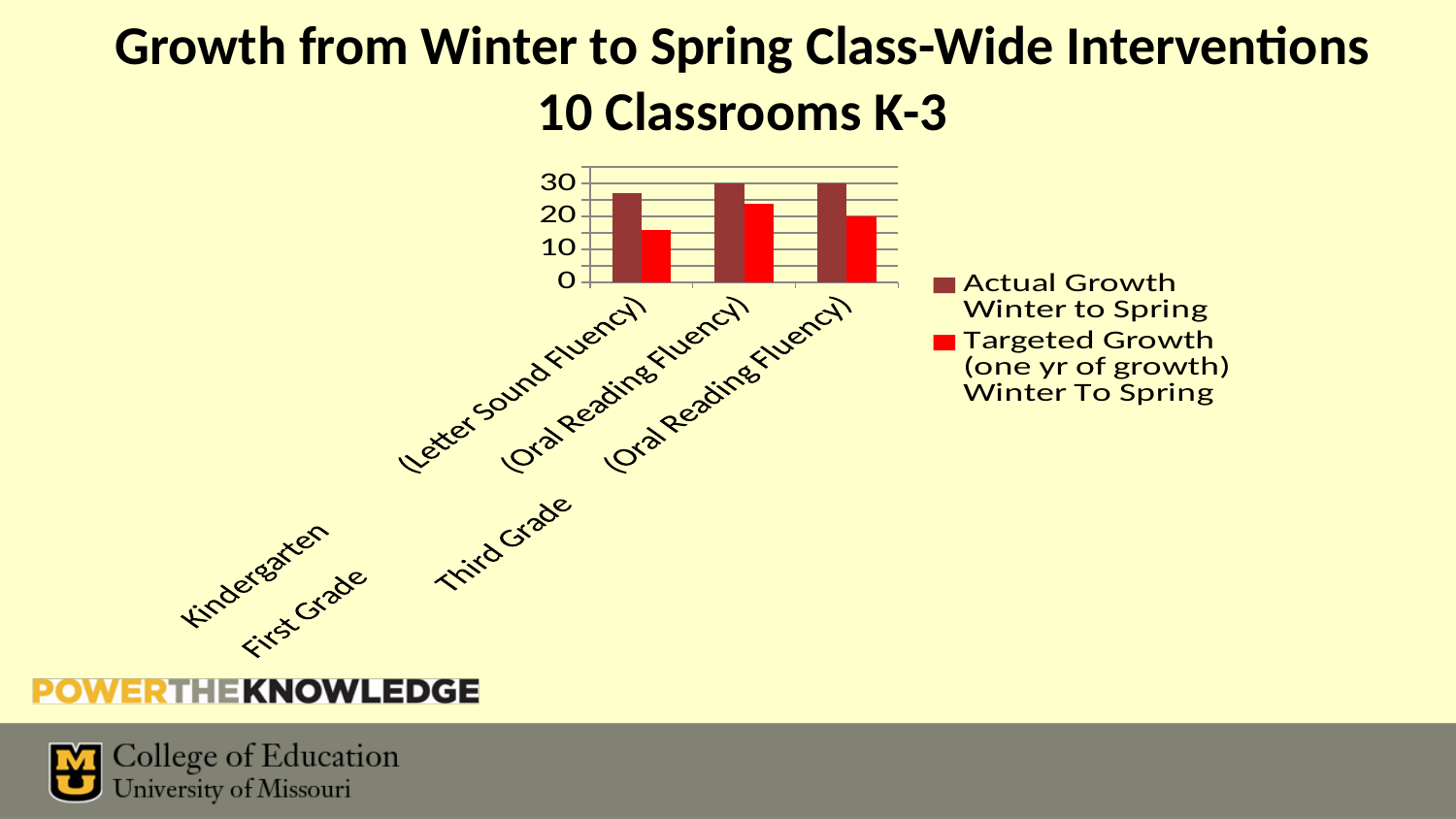
Is the Targeted Growth value for Third Grade (Oral Reading Fluency) greater or less than 30? less Is the Targeted Growth value for Kindergarten (Letter Sound Fluency) greater or less than 20? less Which grade has the highest Targeted Growth value? First Grade (Oral Reading Fluency) What kind of chart is shown on the slide? bar chart For Kindergarten (Letter Sound Fluency), which is larger: Actual Growth Winter to Spring or Targeted Growth? Actual Growth Winter to Spring How many series does the legend list? 2 Is the Targeted Growth value for First Grade (Oral Reading Fluency) greater or less than 20? greater What is the title of the slide containing the chart? Growth from Winter to Spring Class-Wide Interventions 10 Classrooms K-3 Which grade has the lowest Targeted Growth value? Kindergarten (Letter Sound Fluency) How many grade-level categories are plotted on the x axis? 3 What colour represents Targeted Growth (one yr of growth) Winter To Spring in the legend? red